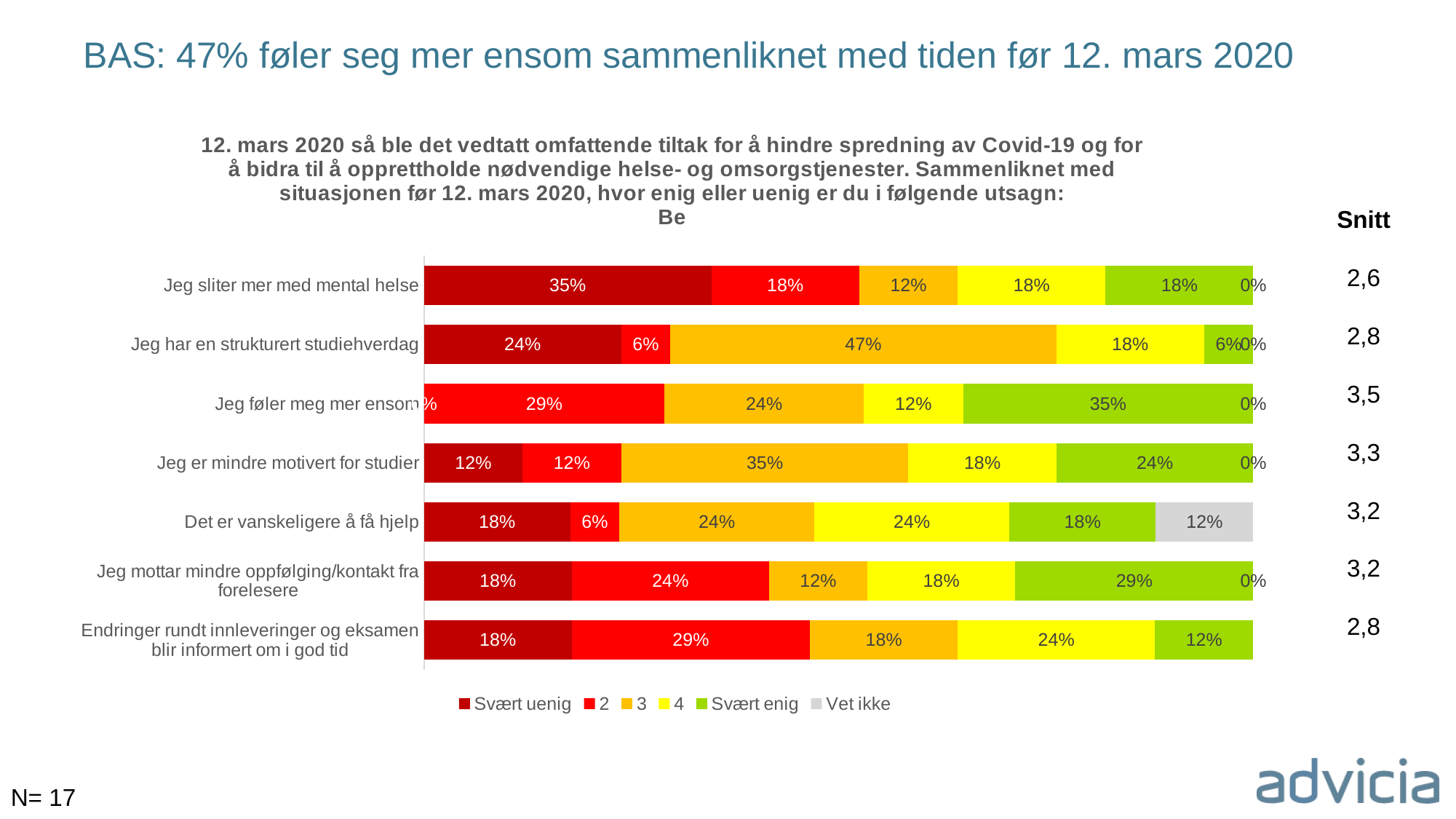
What is the "Snitt" (average) value shown for "Jeg føler meg mer ensom"? 3,5 How many series does the legend list? 6 What is the difference between the "Svært enig" share for "Jeg føler meg mer ensom" and for "Endringer rundt innleveringer og eksamen blir informert om i god tid"? 23 percentage points What colour represents "Vet ikke" in the legend? Grey How many statements (categories) are shown in the chart? 7 What type of chart is shown on the slide? Stacked bar chart What percentage answered "3" for "Jeg har en strukturert studiehverdag"? 47% Which statement has the highest "Svært enig" share? Jeg føler meg mer ensom What percentage of respondents answered "Svært uenig" to "Jeg sliter mer med mental helse"? 35% What percentage answered "Vet ikke" for "Det er vanskeligere å få hjelp"? 12% Which statement has the lowest "Snitt" value? Jeg sliter mer med mental helse Which is larger: the "Svært uenig" share for "Jeg sliter mer med mental helse" or for "Jeg er mindre motivert for studier"? Jeg sliter mer med mental helse